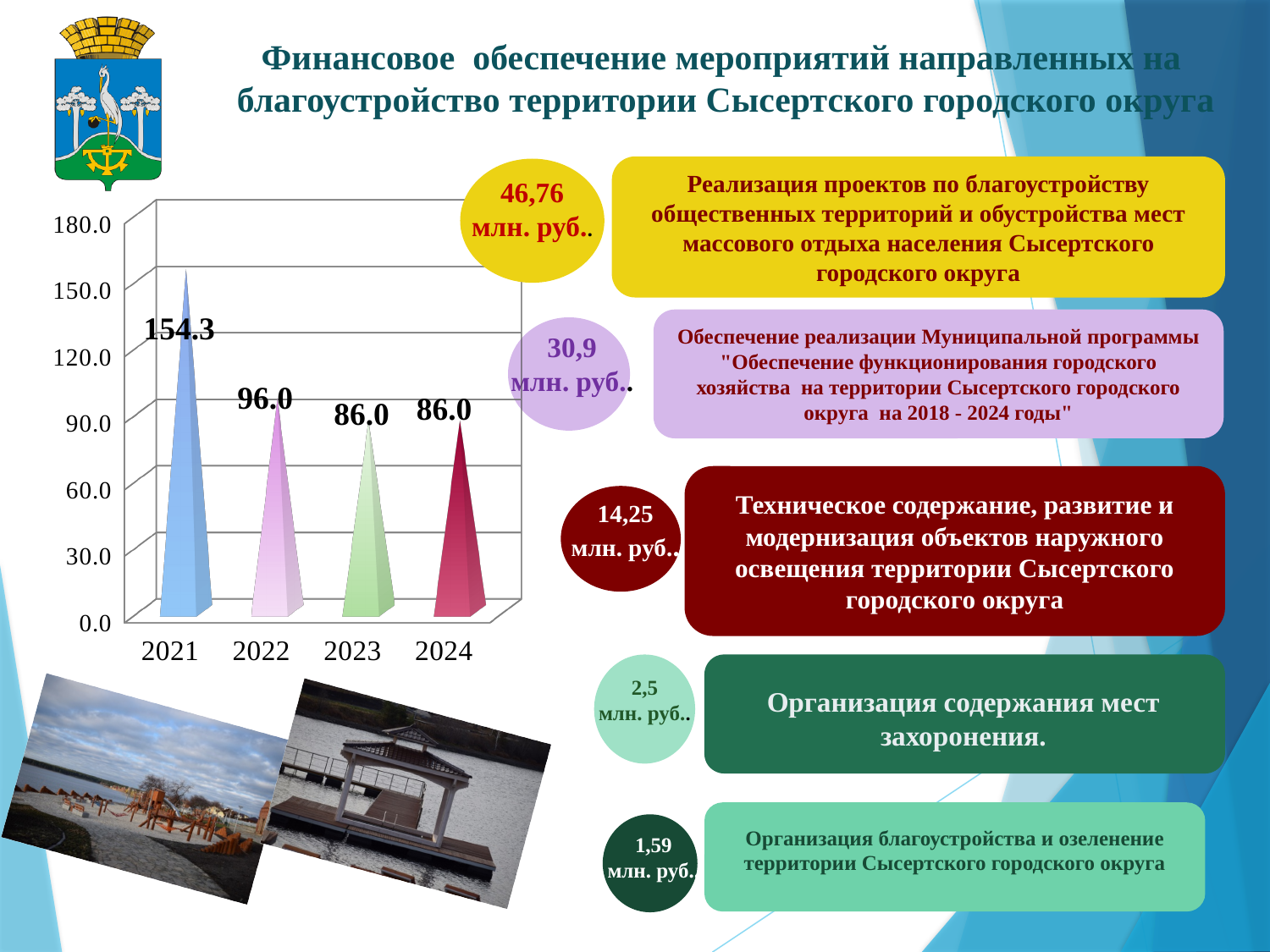
Do the values in the chart generally rise or fall from 2021 to 2024? fall What is the value for 2021 in the chart? 154.3 Which year has the highest value in the chart? 2021 What is the value for 2024 in the chart? 86.0 Is the value for 2021 greater or less than 150.0? greater What is the value for 2022 in the chart? 96.0 How many years are shown on the x axis of the chart? 4 What kind of chart is shown on the slide? bar chart What is the difference between the values for 2022 and 2023? 10.0 What is the value for 2023 in the chart? 86.0 Which is larger, the value for 2021 or the value for 2024? 2021 What is the difference between the values for 2021 and 2022? 58.3